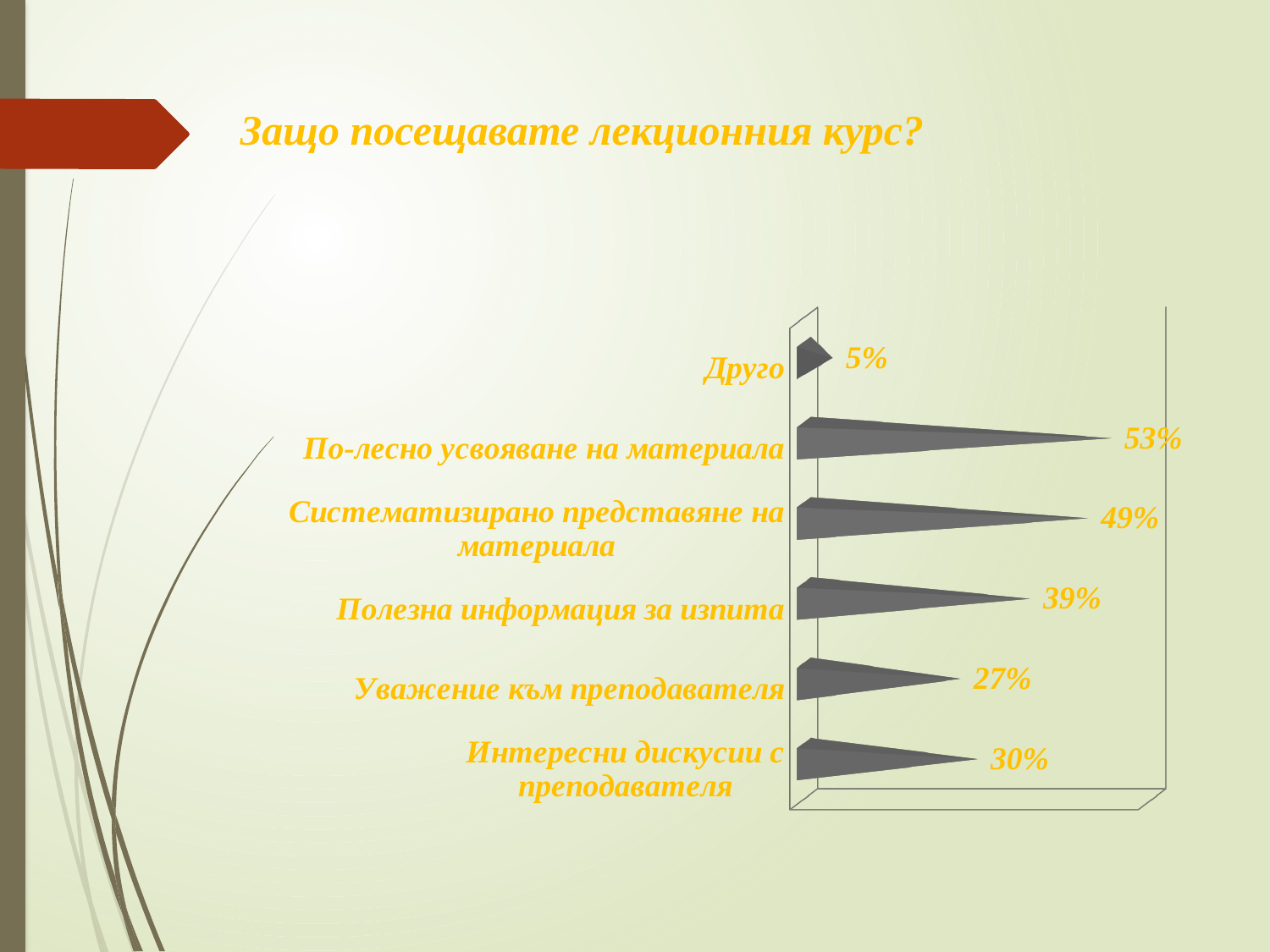
What is the value for "Полезна информация за изпита"? 39% What is the title of the slide containing the chart? Защо посещавате лекционния курс? What is the value for "Интересни дискусии с преподавателя"? 30% What is the value for "Уважение към преподавателя"? 27% Which category has the highest value? По-лесно усвояване на материала What is the value for "Систематизирано представяне на материала"? 49% Which is larger: the value for "Интересни дискусии с преподавателя" or the value for "Уважение към преподавателя"? Интересни дискусии с преподавателя What is the value for "Друго"? 5% What is the value for "По-лесно усвояване на материала"? 53% How many categories are shown in the chart? 6 Which category has the lowest value? Друго What is the difference between the values for "По-лесно усвояване на материала" and "Систематизирано представяне на материала"? 4%